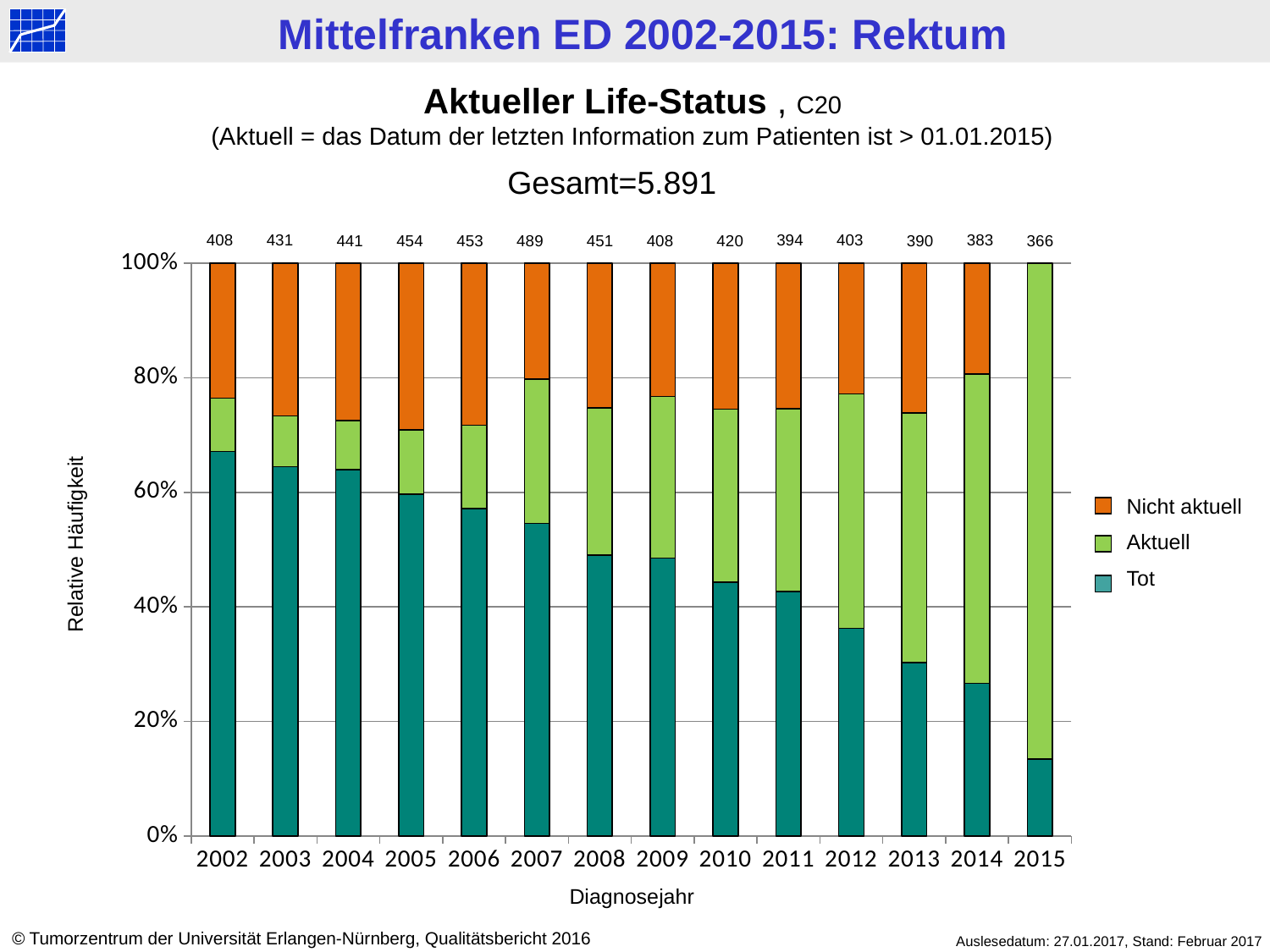
What is the difference between the numbers printed above the bars for 2007 and 2015? 123 Is the share of 'Tot' in 2015 greater or less than 20%? less What number is printed above the bar for 2007? 489 How many diagnosis years are shown on the x axis? 14 How many series does the legend list? 3 Does the share of 'Tot' rise or fall from 2002 to 2015? Fall Is the share of 'Tot' in 2002 greater or less than 60%? greater Which diagnosis year has the lowest number printed above its bar? 2015 Which diagnosis year has the highest number printed above its bar? 2007 What kind of chart is shown on the slide? Stacked bar chart Which has the larger number printed above its bar, 2004 or 2005? 2005 What number is printed above the bar for 2015? 366